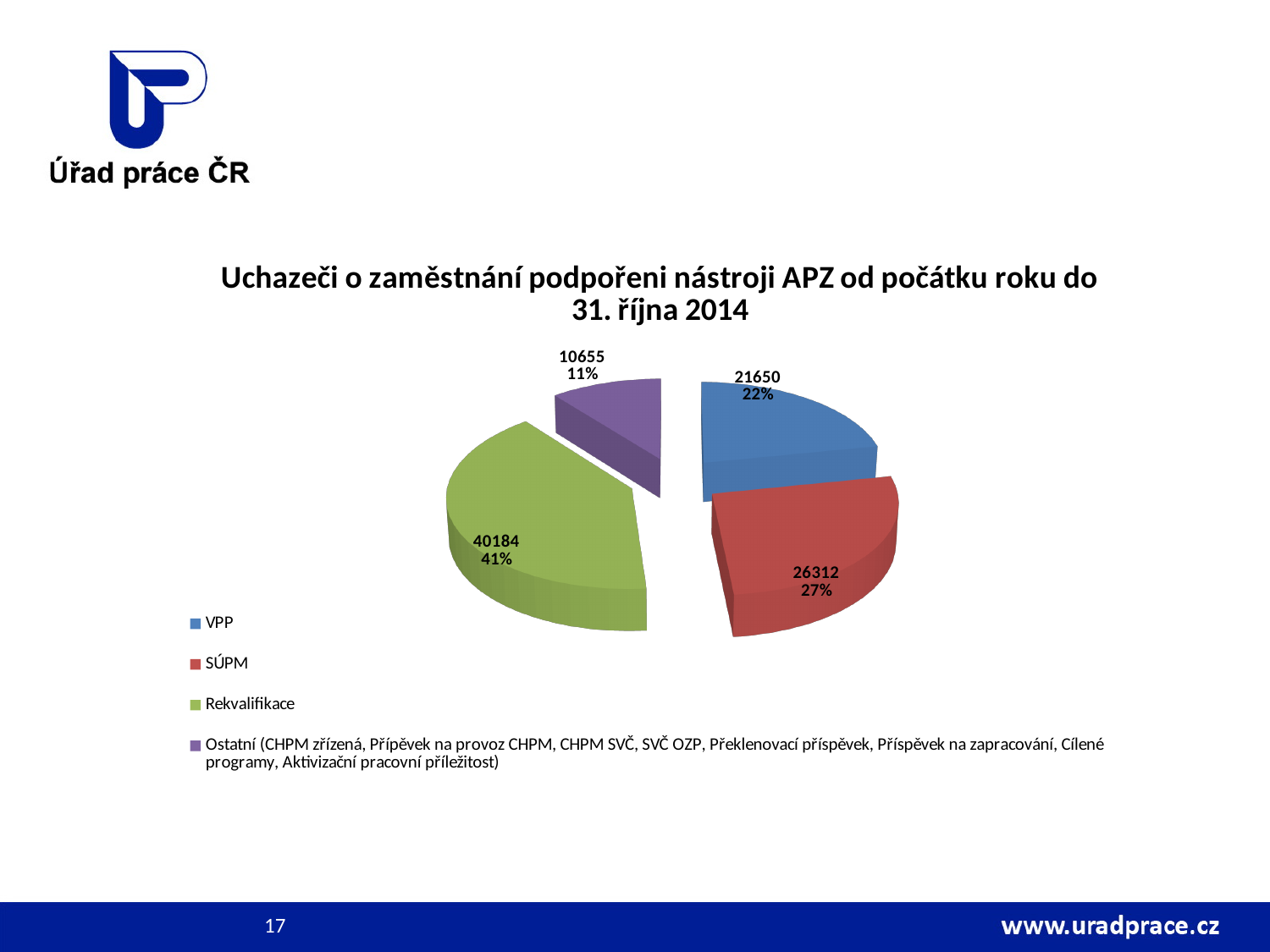
Which category has the largest slice of the pie? Rekvalifikace Which category has the smallest slice of the pie? Ostatní What is the difference between the values for SÚPM and VPP? 4662 What is the value for SÚPM? 26312 What kind of chart is shown on the slide? pie chart Which is larger, the value for SÚPM or the value for VPP? SÚPM What share of the pie does Rekvalifikace represent? 41% What share of the pie does VPP represent? 22% How many slices does the pie chart have? 4 What is the value for the Ostatní category? 10655 What is the value for Rekvalifikace? 40184 What is the value for VPP? 21650